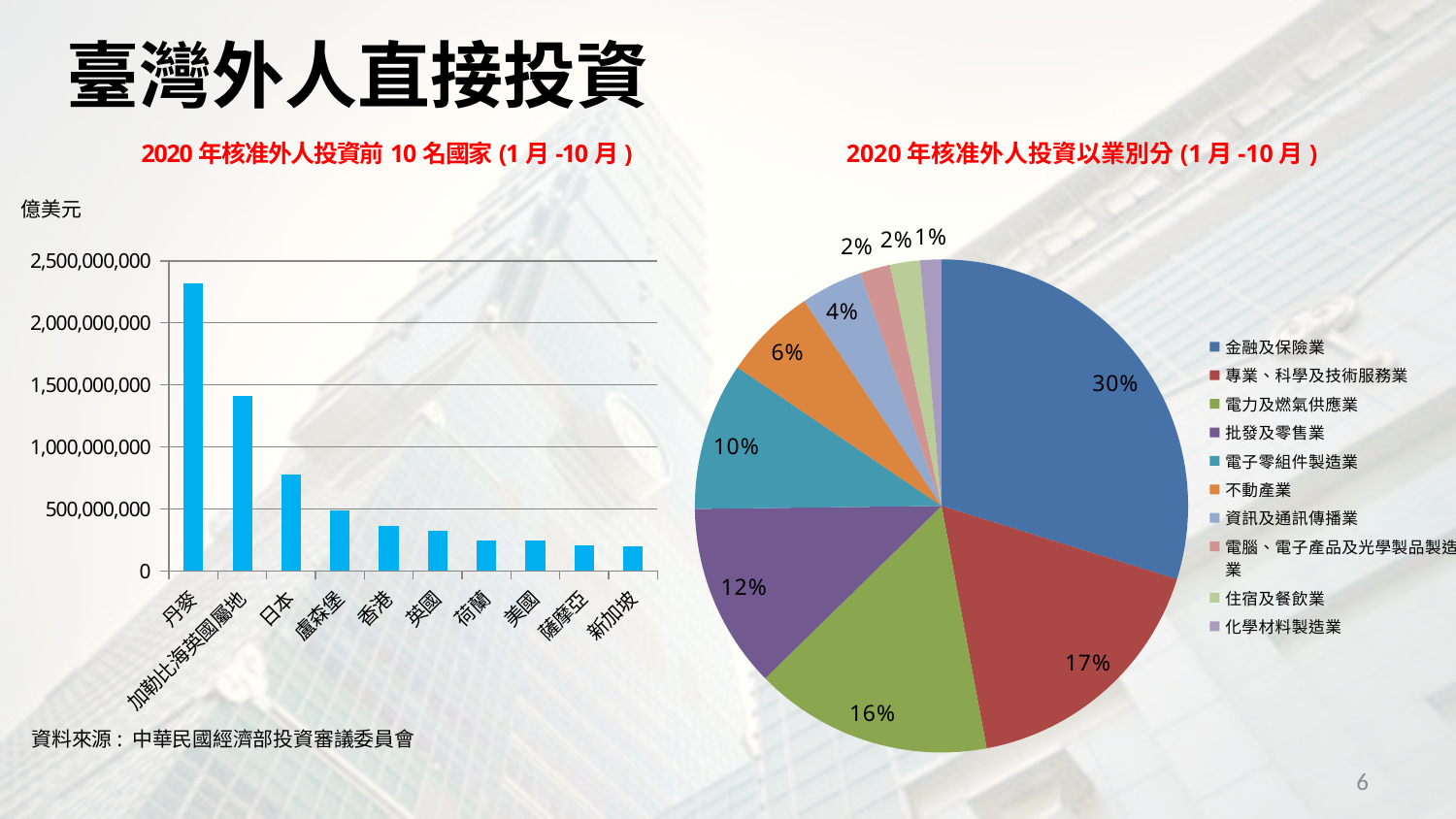
What kind of chart is the left chart titled 2020 年核准外人投資前 10 名國家 (1 月 -10 月 )? bar chart In the left bar chart (2020 年核准外人投資前 10 名國家), do the values rise or fall from left to right along the x axis? fall In the left bar chart (2020 年核准外人投資前 10 名國家), how many countries are shown? 10 In the right pie chart (2020 年核准外人投資以業別分), which industry has the largest slice? 金融及保險業 In the right pie chart (2020 年核准外人投資以業別分), how many industries does the legend list? 10 In the left bar chart (2020 年核准外人投資前 10 名國家), which is larger, the value for 加勒比海英國屬地 or for 日本? 加勒比海英國屬地 What unit label is shown above the vertical axis of the left bar chart? 億美元 In the left bar chart (2020 年核准外人投資前 10 名國家), is the value for 日本 greater or less than 1,000,000,000? less In the right pie chart (2020 年核准外人投資以業別分), what share does 金融及保險業 have? 30% In the right pie chart (2020 年核准外人投資以業別分), what share does 電子零組件製造業 have? 10% In the left bar chart (2020 年核准外人投資前 10 名國家), is the value for 丹麥 greater or less than 2,000,000,000? greater In the left bar chart (2020 年核准外人投資前 10 名國家), which country has the highest value? 丹麥